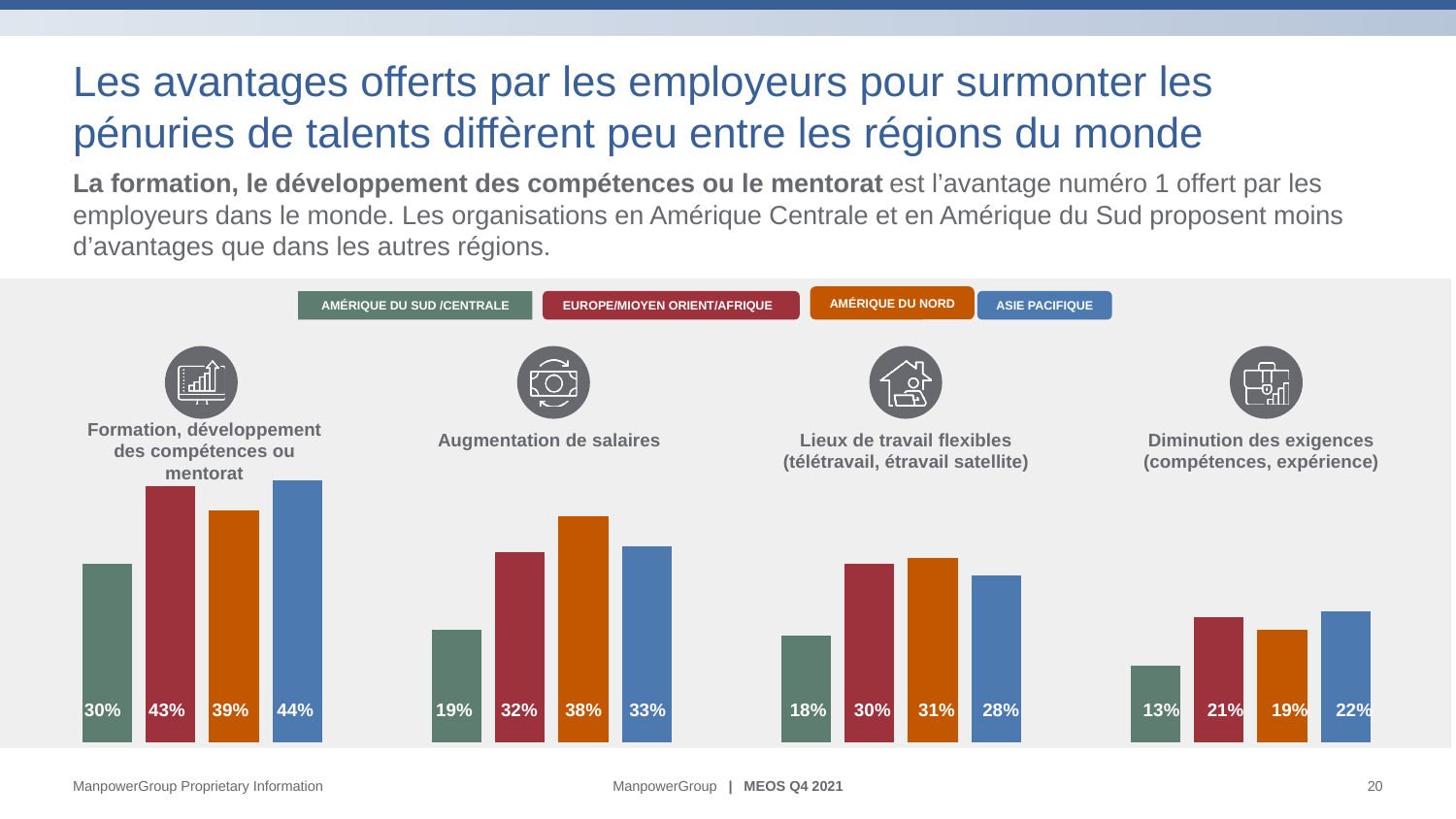
In the 'Augmentation de salaires' chart, what is the value for Amérique du Nord? 38% In the 'Lieux de travail flexibles (télétravail, étravail satellite)' chart, what is the difference between the values for Amérique du Nord and Asie Pacifique? 3 percentage points In the 'Diminution des exigences (compétences, expérience)' chart, which region has the lowest value? Amérique du Sud/Centrale In the 'Formation, développement des compétences ou mentorat' chart, what is the value for Asie Pacifique? 44% In the 'Diminution des exigences (compétences, expérience)' chart, what is the value for Europe/Moyen Orient/Afrique? 21% In the 'Formation, développement des compétences ou mentorat' chart, what is the difference between the values for Asie Pacifique and Amérique du Sud/Centrale? 14 percentage points How many bars are shown in the 'Diminution des exigences (compétences, expérience)' chart? 4 In the 'Lieux de travail flexibles (télétravail, étravail satellite)' chart, what is the value for Amérique du Sud/Centrale? 18% How many regions does the legend at the top of the charts list? 4 What type of chart is used for 'Augmentation de salaires'? Bar chart In the 'Augmentation de salaires' chart, which region has the highest value? Amérique du Nord In the 'Augmentation de salaires' chart, which is larger: the value for Europe/Moyen Orient/Afrique or the value for Amérique du Sud/Centrale? Europe/Moyen Orient/Afrique